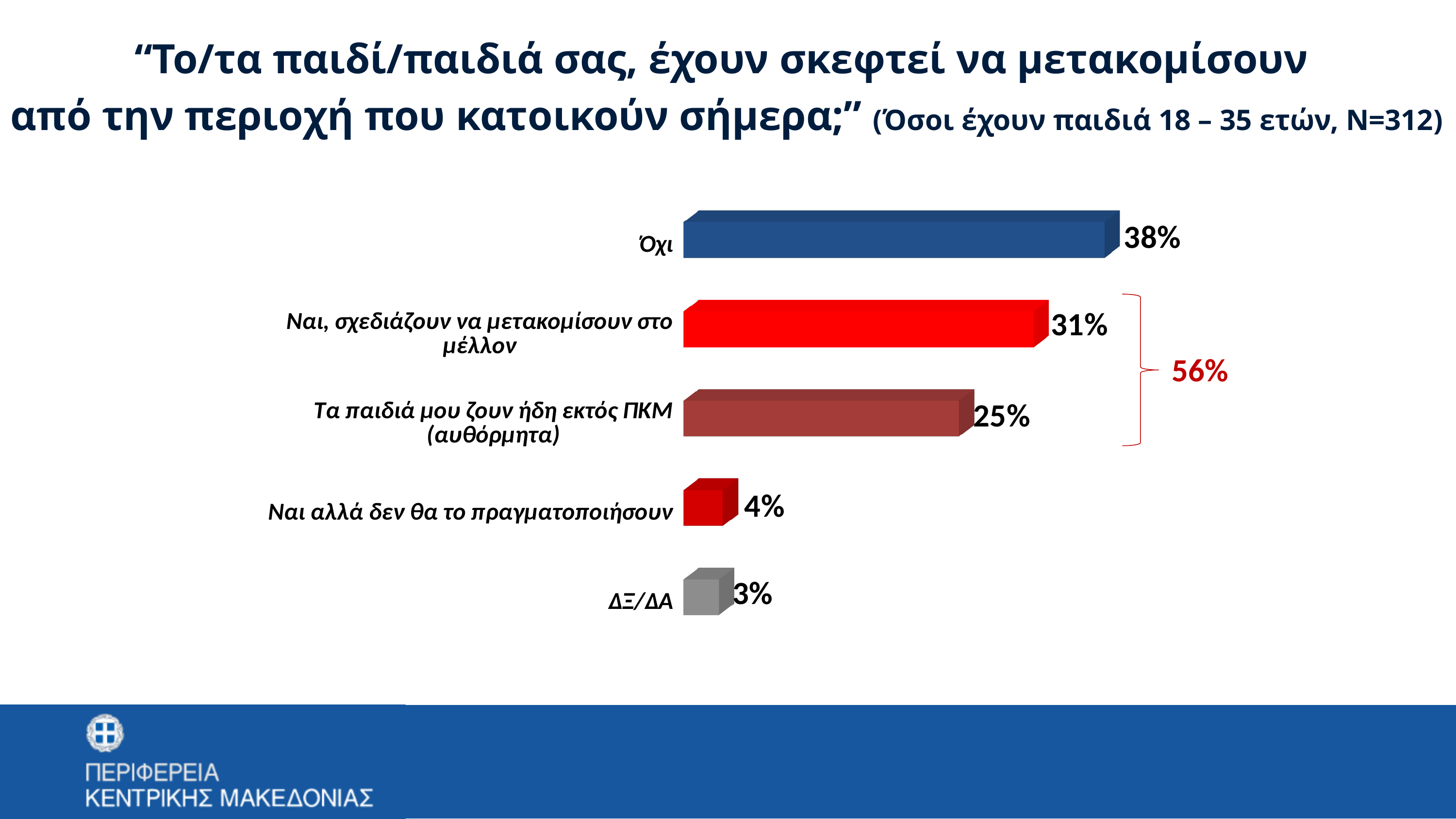
What percentage is shown for "ΔΞ/ΔΑ"? 3% Which category has the highest value? Όχι What combined percentage is shown by the bracket grouping the two middle bars? 56% What kind of chart is shown on the slide? Bar chart How many categories are shown in the chart? 5 What percentage is shown for "Ναι, σχεδιάζουν να μετακομίσουν στο μέλλον"? 31% What percentage is shown for "Ναι αλλά δεν θα το πραγματοποιήσουν"? 4% Which is larger: the value for "Τα παιδιά μου ζουν ήδη εκτός ΠΚΜ (αυθόρμητα)" or the value for "Ναι αλλά δεν θα το πραγματοποιήσουν"? Τα παιδιά μου ζουν ήδη εκτός ΠΚΜ (αυθόρμητα) What percentage is shown for "Τα παιδιά μου ζουν ήδη εκτός ΠΚΜ (αυθόρμητα)"? 25% Which category has the lowest value? ΔΞ/ΔΑ What percentage is shown for "Όχι"? 38% What is the difference between the values for "Όχι" and "Ναι, σχεδιάζουν να μετακομίσουν στο μέλλον"? 7%